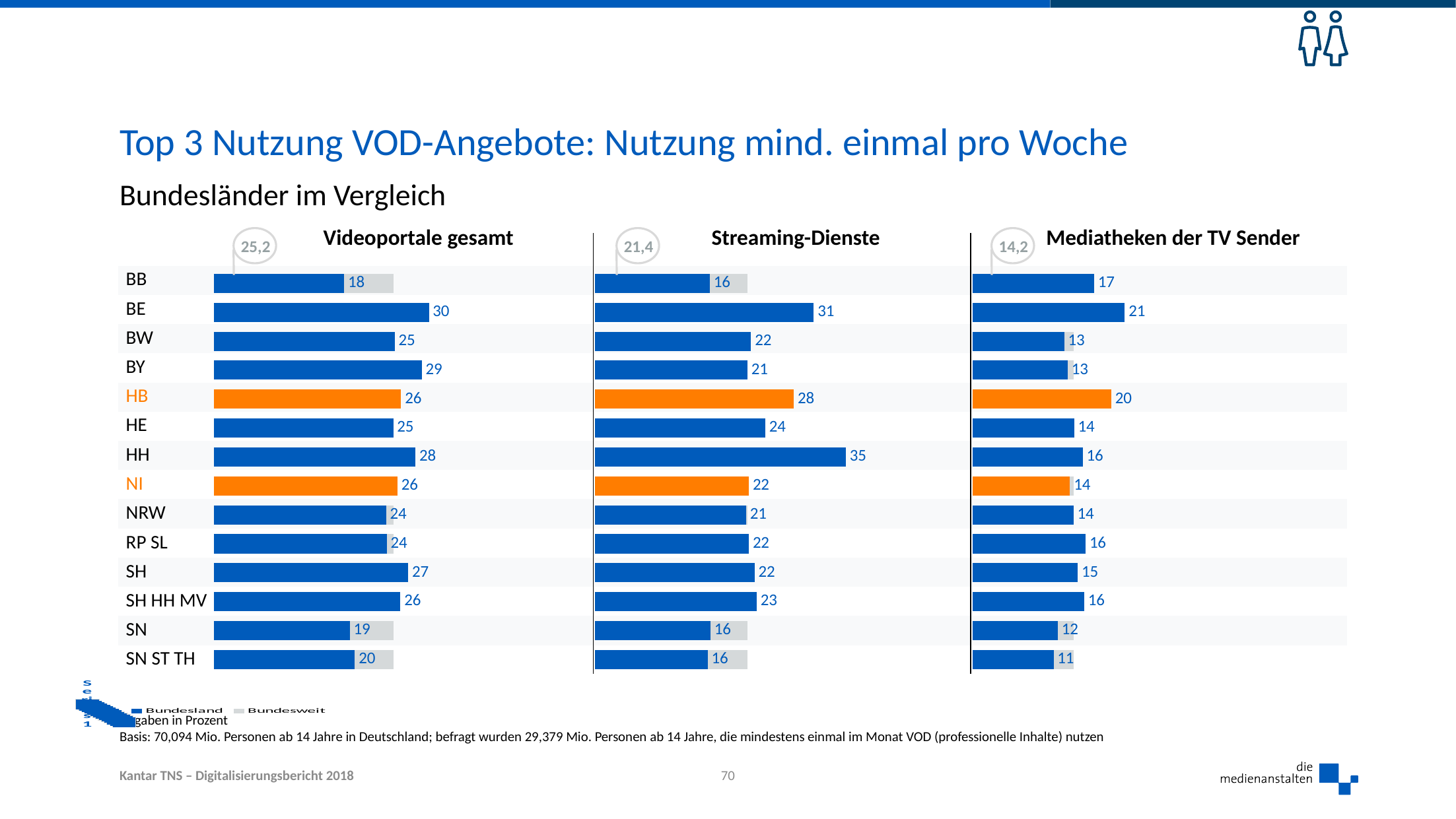
In the "Videoportale gesamt" chart, what is the difference between the values for BE and BB? 12 In the "Videoportale gesamt" chart, which Bundesland has the lowest value? BB In the "Streaming-Dienste" chart, which is larger, the value for HH or the value for BE? HH In the "Mediatheken der TV Sender" chart, which Bundesland has the highest value? BE What is the Bundesweit (nationwide) value shown for "Streaming-Dienste"? 21,4 In the "Streaming-Dienste" chart, what is the value for HB? 28 In the "Mediatheken der TV Sender" chart, what is the difference between the values for HB and SN? 8 In the "Streaming-Dienste" chart, which Bundesland has the highest value? HH In the "Videoportale gesamt" chart, what is the value for BE? 30 In the "Mediatheken der TV Sender" chart, what is the value for SN ST TH? 11 How many Bundesländer (categories) are shown in the "Videoportale gesamt" chart? 14 What kind of chart is used for "Mediatheken der TV Sender"? bar chart